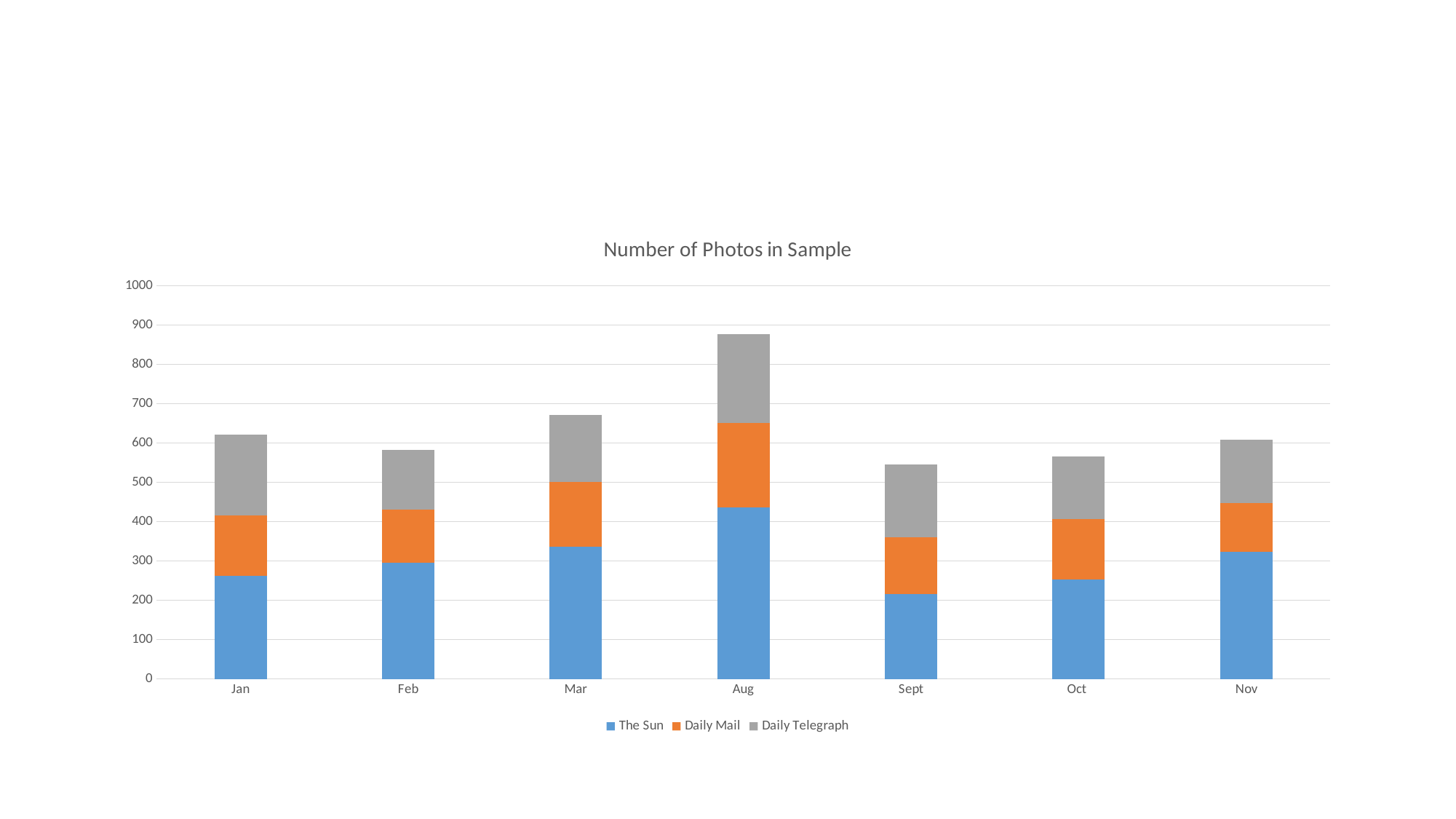
Is the value for The Sun in Aug greater or less than 400? greater Which month has the lowest value for The Sun? Sept How many series does the legend list? 3 Is the total for Sept greater or less than 600? less Is the total for Aug greater or less than 800? greater How many months are shown on the x axis? 7 Which is larger, the total for Aug or the total for Jan? Aug What is the title of the chart? Number of Photos in Sample What type of chart is shown on the slide? Stacked bar chart Which month has the highest value for The Sun? Aug Which colour represents Daily Telegraph in the chart? Grey Which month has the highest total number of photos? Aug